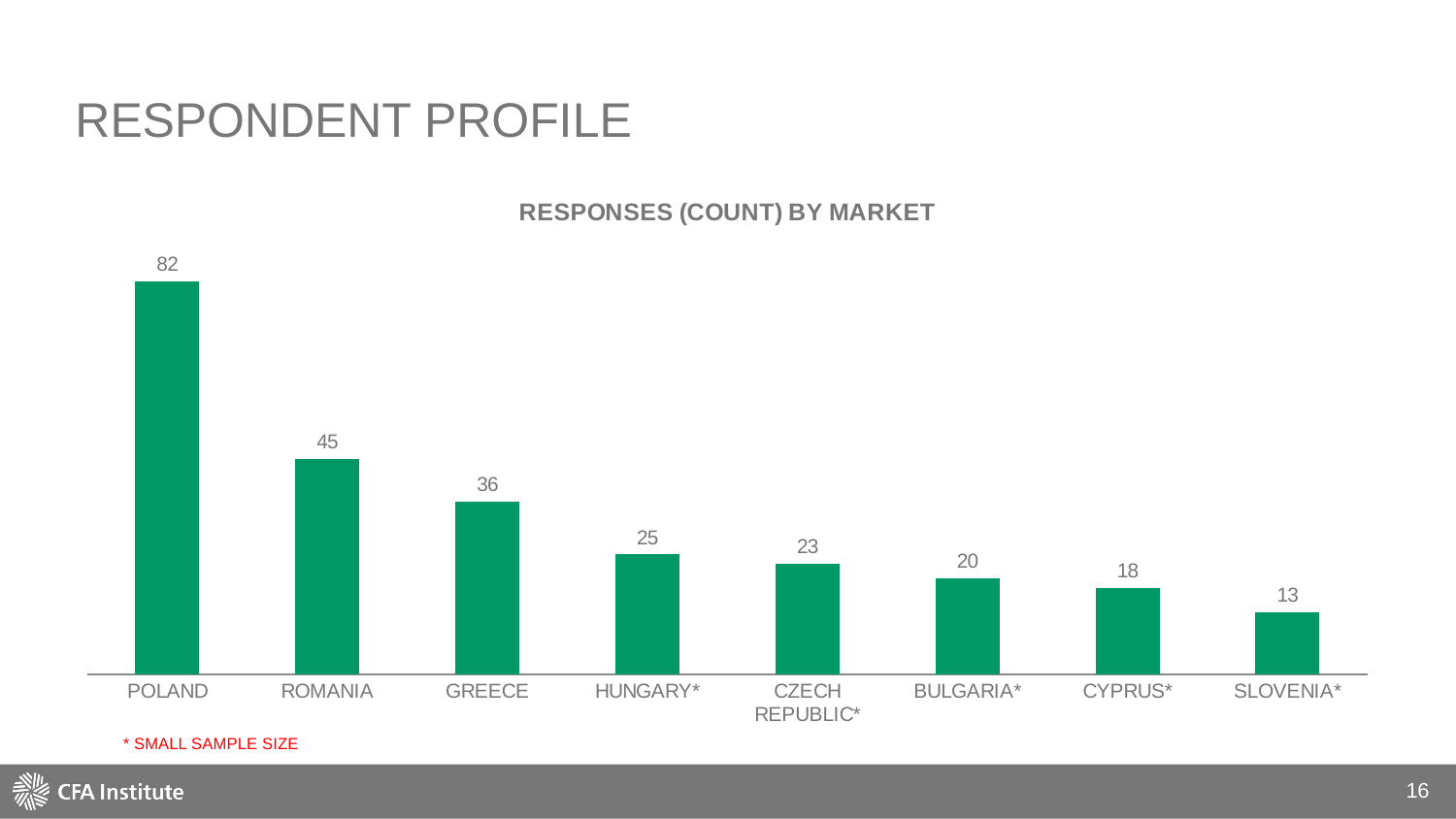
Do the response counts rise or fall from left to right across the markets? Fall What is the difference between the response counts for Greece and Hungary? 11 Which market has the highest response count? Poland What is the response count for Poland? 82 What kind of chart is shown on the slide? Bar chart What is the response count for Czech Republic? 23 What is the title of the chart? RESPONSES (COUNT) BY MARKET Which has a higher response count, Bulgaria or Cyprus? Bulgaria What is the response count for Cyprus? 18 What is the difference between the response counts for Poland and Romania? 37 How many markets are shown in the chart? 8 Which market has the lowest response count? Slovenia